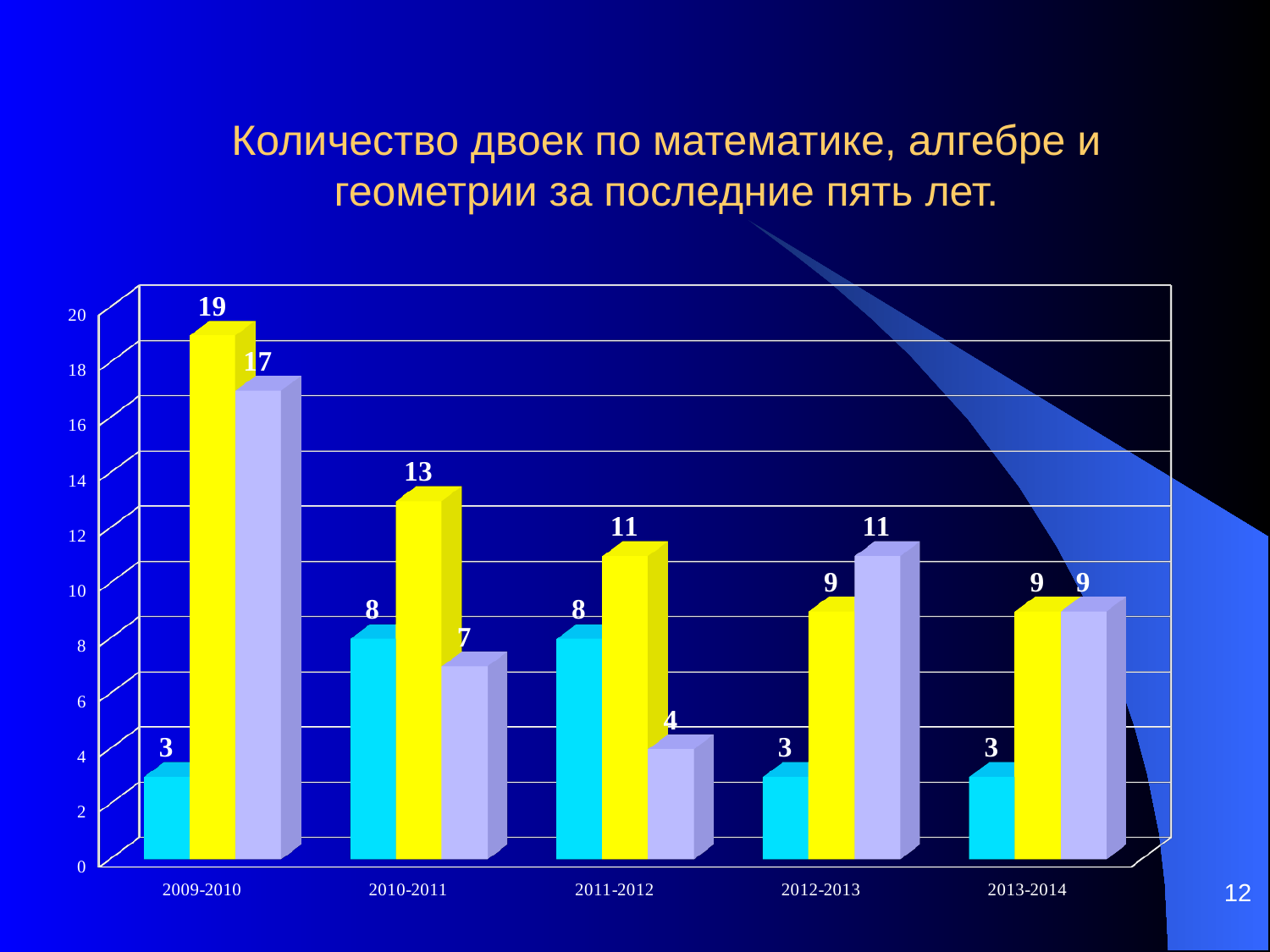
Do the yellow bars rise or fall from 2009-2010 to 2011-2012? fall For 2012-2013, which is larger: the yellow bar or the light purple bar? the light purple bar How many year categories are shown on the x axis? 5 Which year has the highest yellow bar? 2009-2010 What is the difference between the yellow bar and the light purple bar for 2010-2011? 6 Which year has the lowest light purple bar? 2011-2012 What is the value of the cyan bar for 2010-2011? 8 What is the value of the light purple bar for 2011-2012? 4 What is the maximum value shown on the vertical axis? 20 What is the difference between the yellow bar for 2009-2010 and the yellow bar for 2013-2014? 10 What kind of chart is shown on the slide? bar chart What is the value of the yellow bar for 2009-2010? 19